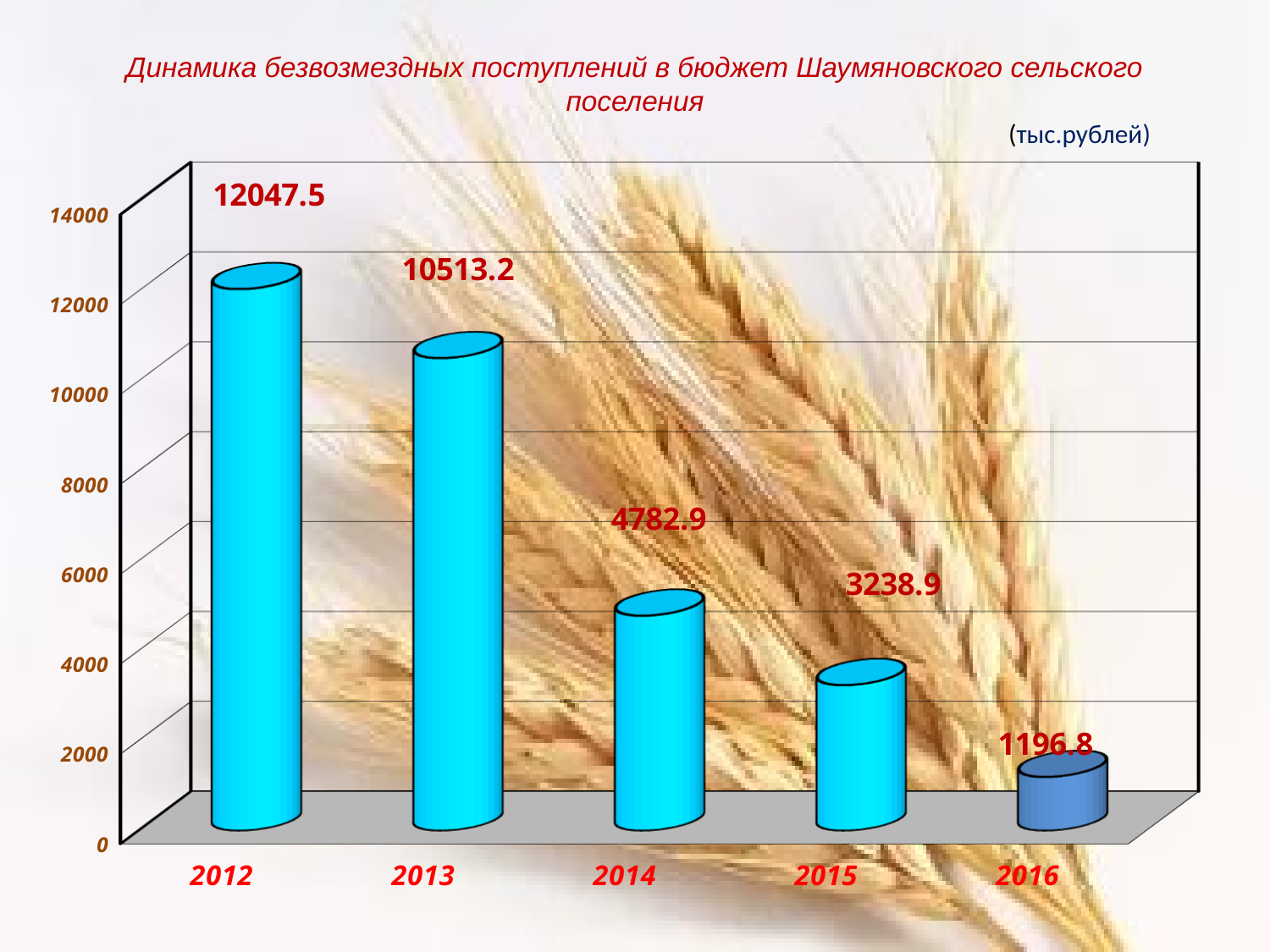
How many years are shown on the x axis? 5 What is the difference between the values for 2015 and 2016? 2042.1 Do the values rise or fall from 2012 to 2016? fall What is the value for 2014? 4782.9 What is the difference between the values for 2012 and 2013? 1534.3 What is the value for 2012? 12047.5 Is the value for 2015 greater or less than 4000? less Which year has the lowest value? 2016 What is the value for 2016? 1196.8 Which year has the highest value? 2012 Which is larger, the value for 2013 or the value for 2014? 2013 What kind of chart is shown on the slide? bar chart